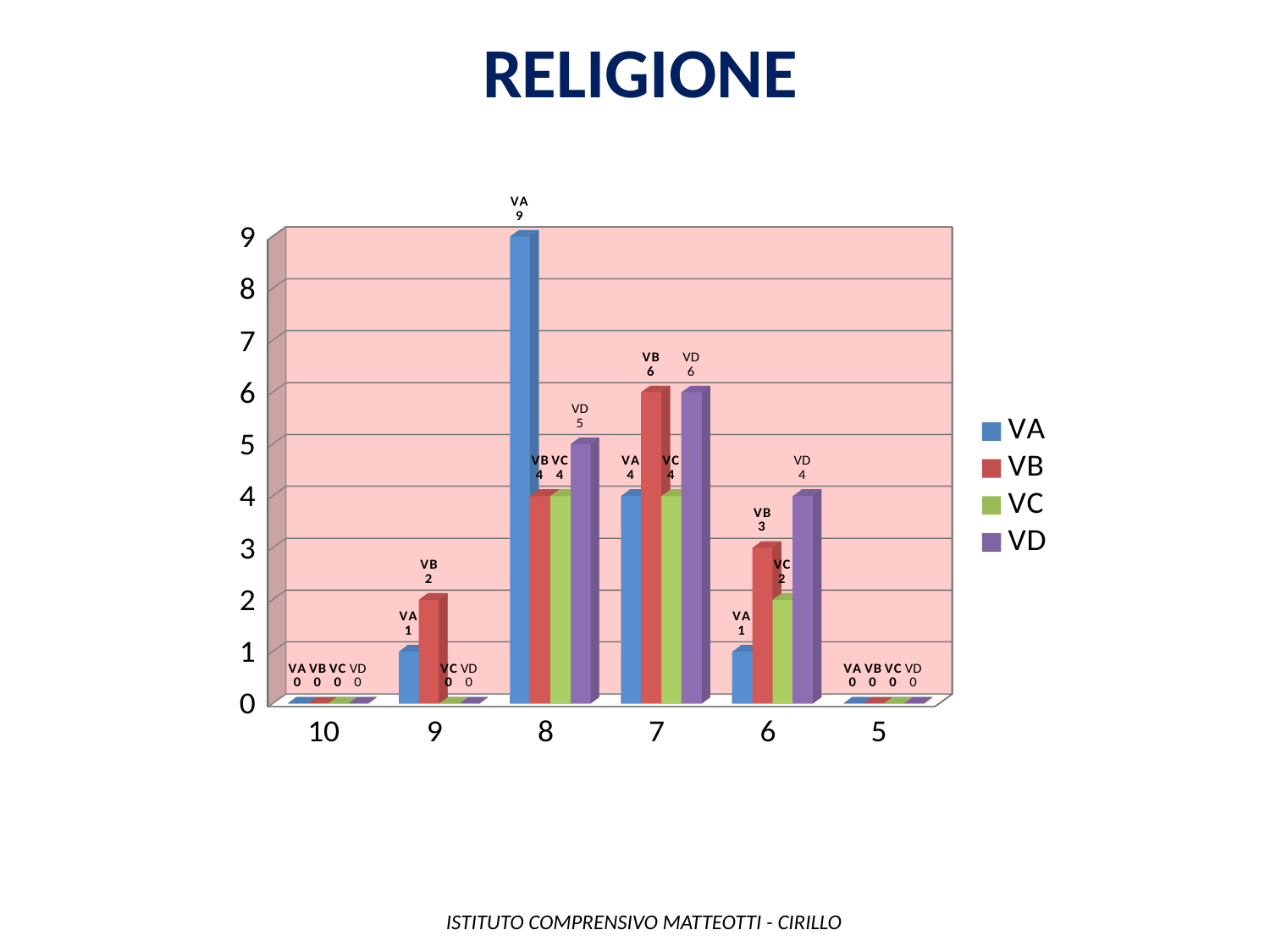
How many categories are shown on the x axis? 6 What is the value for VB at grade 6? 3 What is the title of the chart? RELIGIONE How many series does the legend list? 4 What is the value for VD at grade 8? 5 Which is larger at grade 9: the value for VA or the value for VB? VB What is the difference between the VA value at grade 8 and the VD value at grade 8? 4 What is the value for VA at grade 8? 9 Which series has the highest value at grade 8? VA What kind of chart is shown on the slide? bar chart Which series has the lowest value at grade 6? VA What is the total of the four series values at grade 7? 20